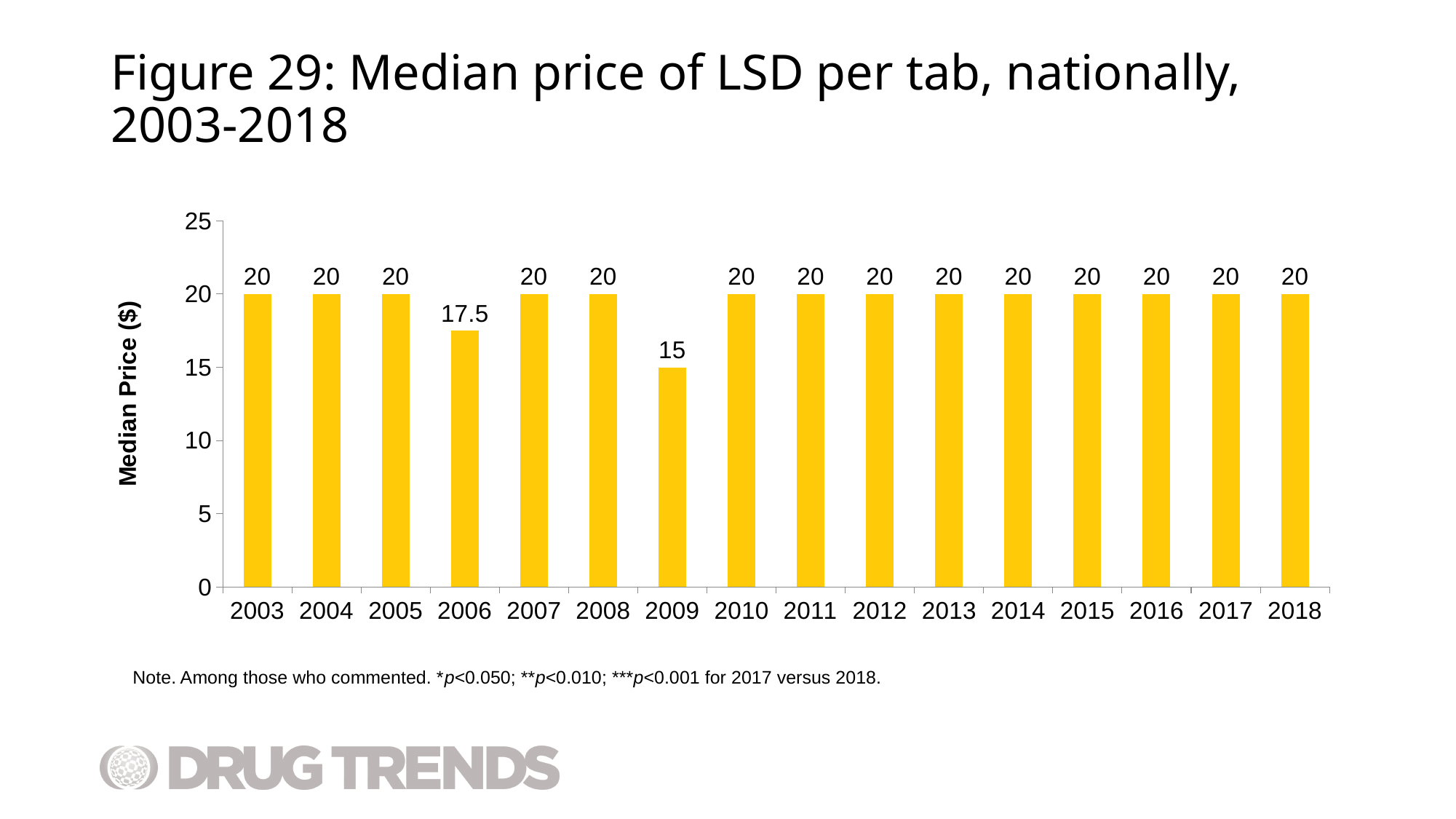
What is the difference between the median price in 2008 and the median price in 2009? 5 What is the median price of LSD per tab in 2006? 17.5 What colour are the bars in the chart? Yellow What is the median price of LSD per tab in 2018? 20 What is the median price of LSD per tab in 2009? 15 How many years are shown on the x axis of the chart? 16 What is the difference between the median price in 2006 and the median price in 2009? 2.5 Is the median price in 2009 greater or less than 20? less What is the label on the y axis of the chart? Median Price ($) Which is larger, the median price in 2006 or the median price in 2007? 2007 What kind of chart is shown on the slide? Bar chart Which year has the lowest median price of LSD per tab? 2009